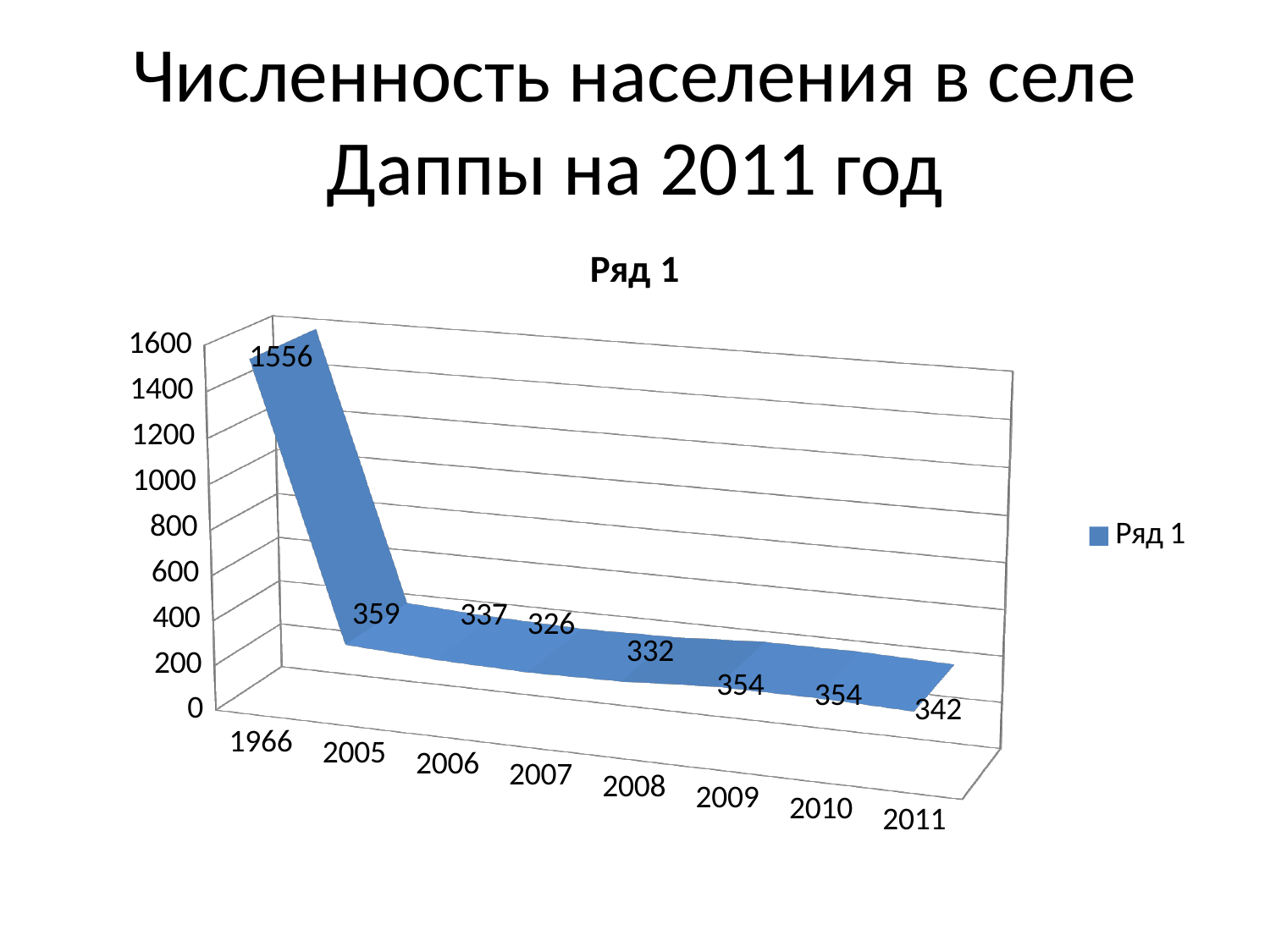
What is the title of the chart? Ряд 1 Which year has the highest value? 1966 How many series does the legend list? 1 What is the difference between the values for 1966 and 2005? 1197 Which is larger, the value for 2005 or the value for 2006? 2005 What is the value for 2007? 326 What is the value for 2011? 342 What is the value for 1966? 1556 What is the difference between the values for 2009 and 2011? 12 How many years are plotted on the x axis? 8 Which year has the lowest value? 2007 What kind of chart is shown on the slide? line chart